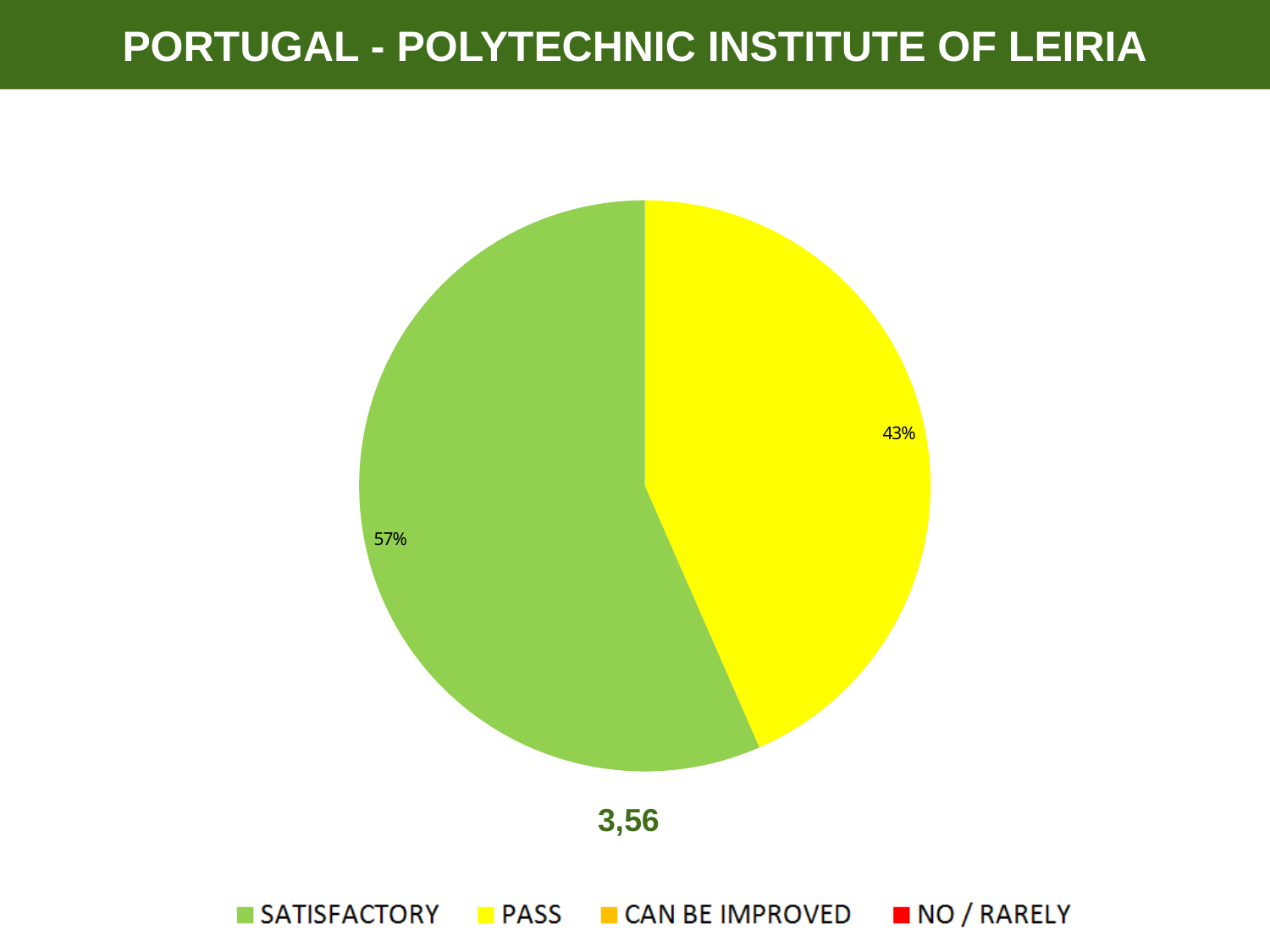
Which is larger, the SATISFACTORY slice or the PASS slice? SATISFACTORY How many slices are visible in the pie? 2 What kind of chart is shown on the slide? pie chart What is the difference in percentage points between the SATISFACTORY and PASS slices? 14 Which category has the largest slice of the pie? SATISFACTORY What share of the pie does SATISFACTORY take? 57% What number is printed below the pie chart? 3,56 What share of the pie does PASS take? 43% Which of the two visible slices is smaller, SATISFACTORY or PASS? PASS How many categories does the legend list? 4 What colour is the PASS slice? yellow Is the share for SATISFACTORY greater or less than 50%? greater